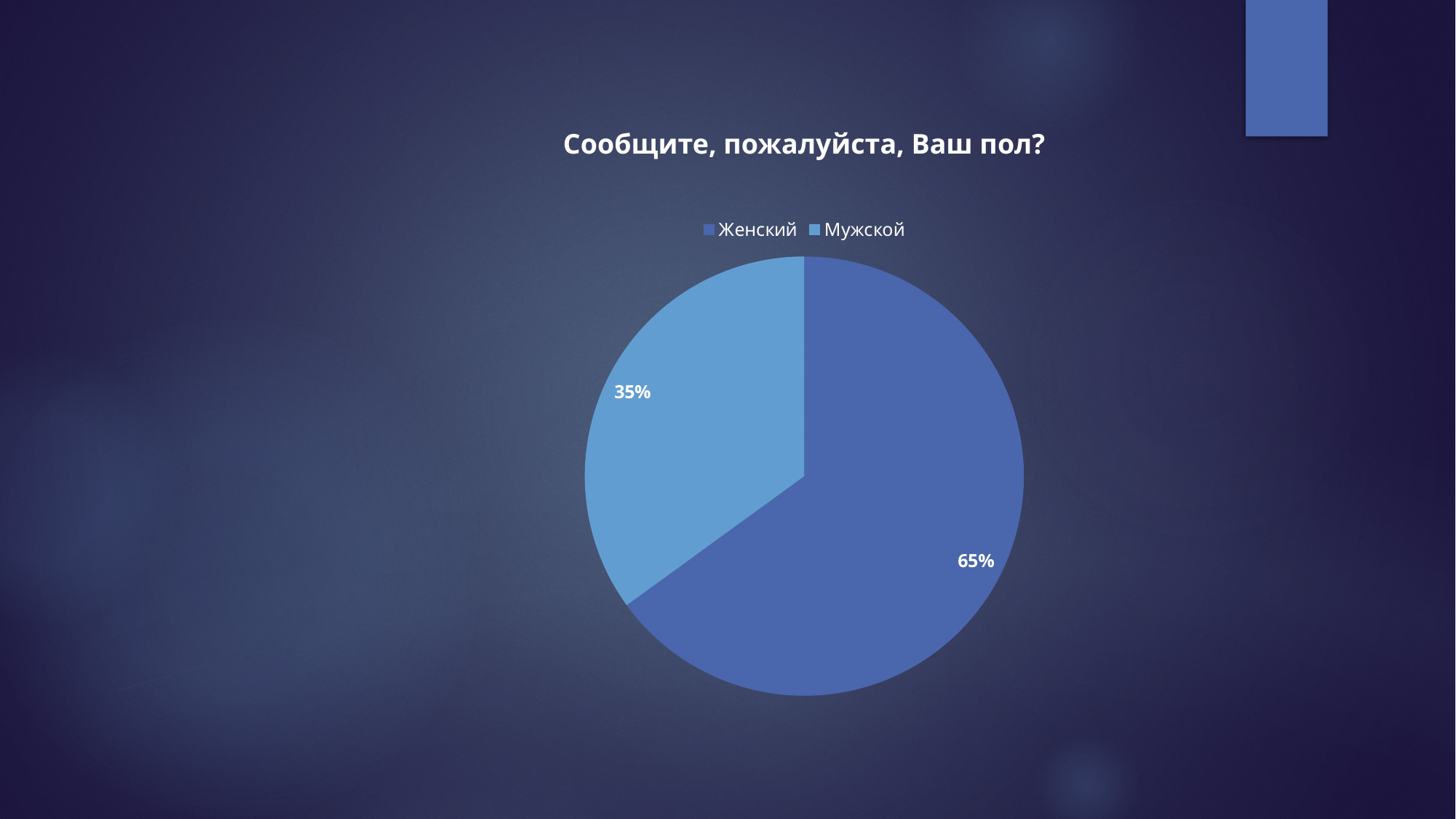
What percentage of the pie is labelled for Женский? 65% Which category has the smallest slice of the pie? Мужской Which category has the largest slice of the pie? Женский What kind of chart is shown on the slide? pie chart Is the value for Женский greater or less than 50%? greater How many slices does the pie chart have? 2 What share of the pie does the Мужской slice represent? 35% What is the title of the chart? Сообщите, пожалуйста, Ваш пол? What percentage of the pie is labelled for Мужской? 35% What is the difference in percentage points between the Женский and Мужской slices? 30 How many entries does the legend list? 2 Which slice is larger, Женский or Мужской? Женский